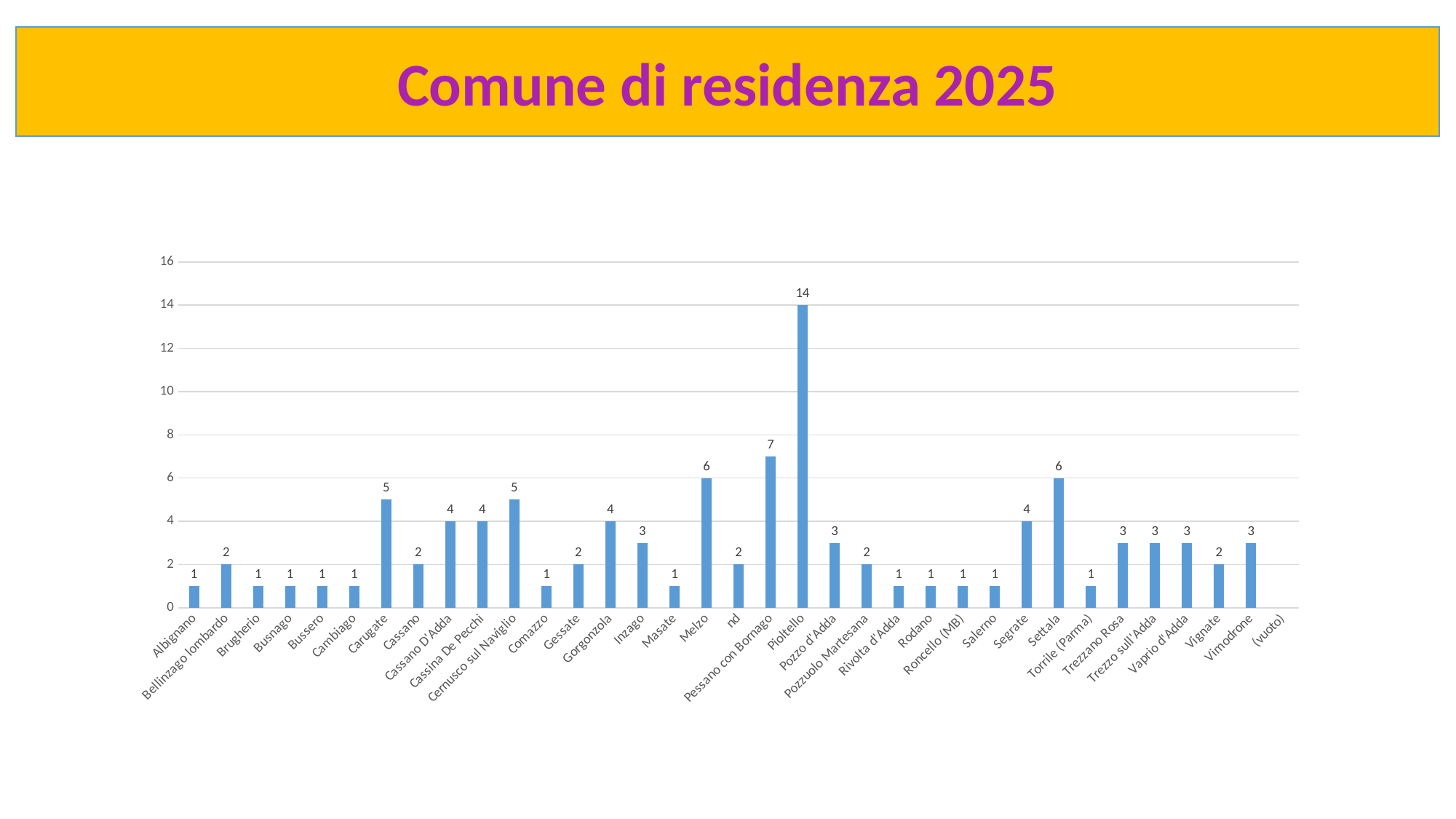
What is the difference between the values for Pioltello and Pessano con Bornago? 7 What is the value for Pessano con Bornago? 7 What is the difference between the values for Melzo and Inzago? 3 What is the value for Pioltello? 14 Which comune has the highest value? Pioltello What kind of chart is shown on the slide? bar chart Which is larger, the value for Settala or the value for Vimodrone? Settala Which is larger, the value for Carugate or the value for Segrate? Carugate What is the title of the slide? Comune di residenza 2025 What is the value for Gorgonzola? 4 What is the value for Cernusco sul Naviglio? 5 Is the value for Pioltello greater or less than 12? greater